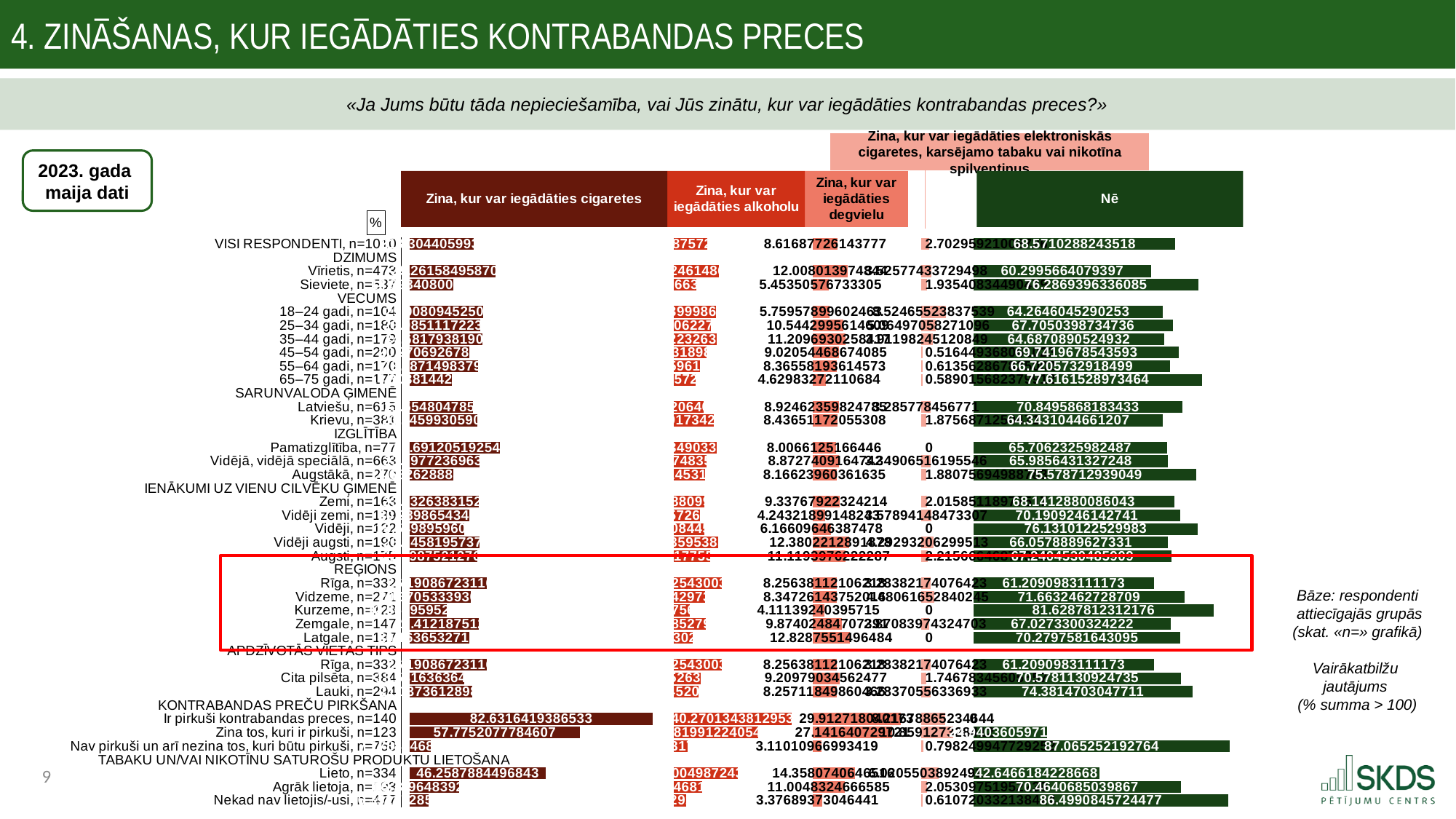
What kind of chart is shown on the slide? bar chart Among the REĢIONS categories, which has the highest value for the "Nē" series? Kurzeme, n=123 What is the value of "Zina, kur var iegādāties cigaretes" for "Ir pirkuši kontrabandas preces, n=140"? 82.6316419386533 What is the value of the "Nē" series for "Vīrietis, n=473"? 60.2995664079397 What is the value of the "Nē" series for "Nekad nav lietojis/-usi, n=477"? 86.4990845724477 How many series does the chart legend list? 5 For the "Nē" series, which is larger: "Vīrietis, n=473" or "Sieviete, n=537"? Sieviete, n=537 What is the value of the "Nē" series for "Sieviete, n=537"? 76.2869396336085 What is the value of the "Nē" series for "VISI RESPONDENTI, n=1010"? 68.5710288243518 What is the value of "Zina, kur var iegādāties cigaretes" for "Zina tos, kuri ir pirkuši, n=123"? 57.7752077784607 What is the value of the "Nē" series for "Kurzeme, n=123"? 81.6287812312176 What is the difference between the "Zina, kur var iegādāties cigaretes" values for "Ir pirkuši kontrabandas preces, n=140" and "Zina tos, kuri ir pirkuši, n=123"? 24.8564341601926